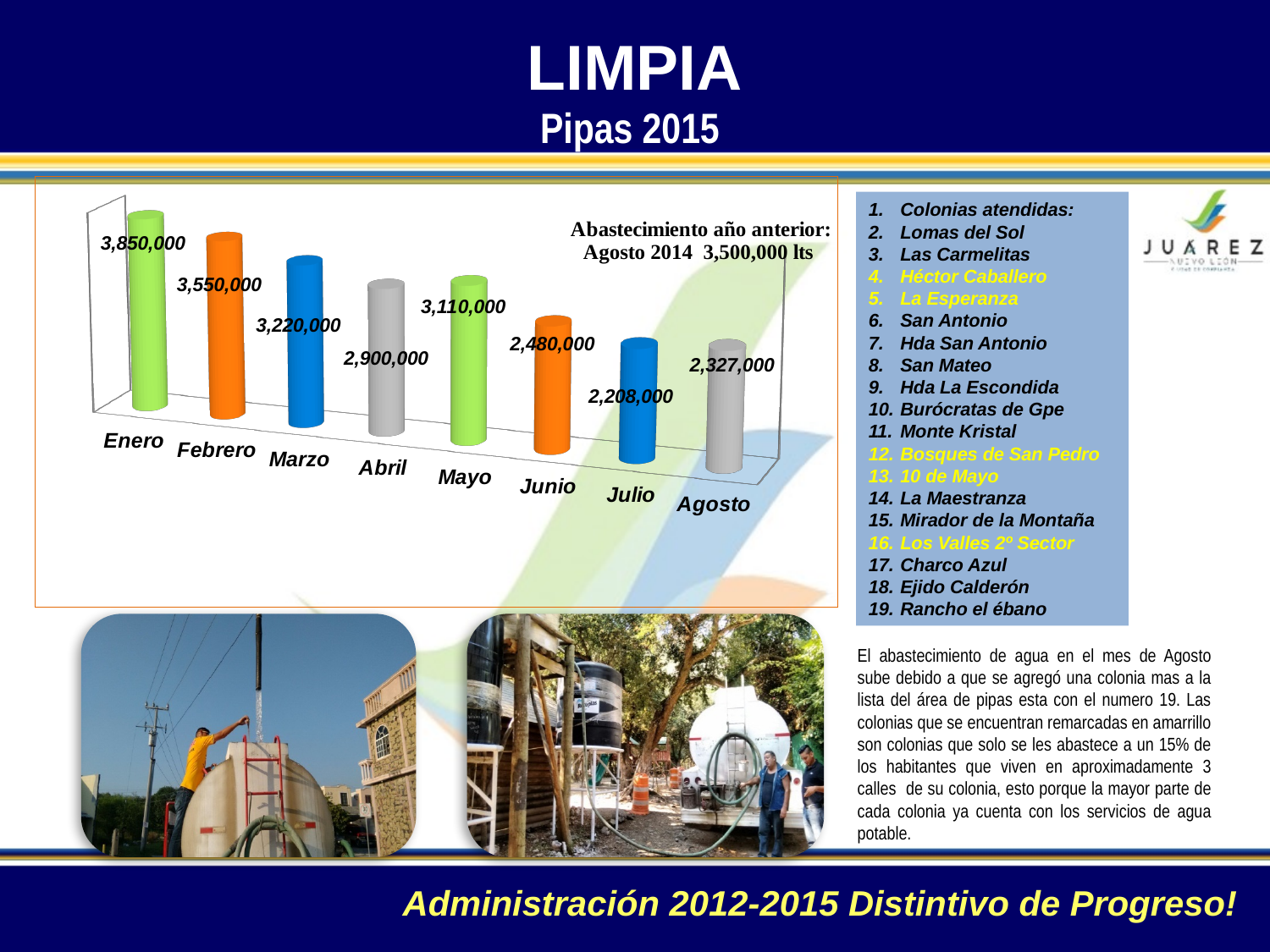
What is the difference between the values for Enero and Agosto? 1,523,000 Which is larger, the value for Mayo or the value for Abril? Mayo Which month has the lowest value? Julio How many months are plotted in the chart? 8 Which month has the highest value? Enero What is the value shown for Agosto? 2,327,000 What kind of chart is shown on the slide? Bar chart According to the note on the chart, what was the supply (abastecimiento) in Agosto 2014? 3,500,000 lts What is the difference between the values for Abril and Mayo? 210,000 What is the value shown for Enero? 3,850,000 What is the value shown for Julio? 2,208,000 Do the values generally rise or fall from Enero to Julio? Fall